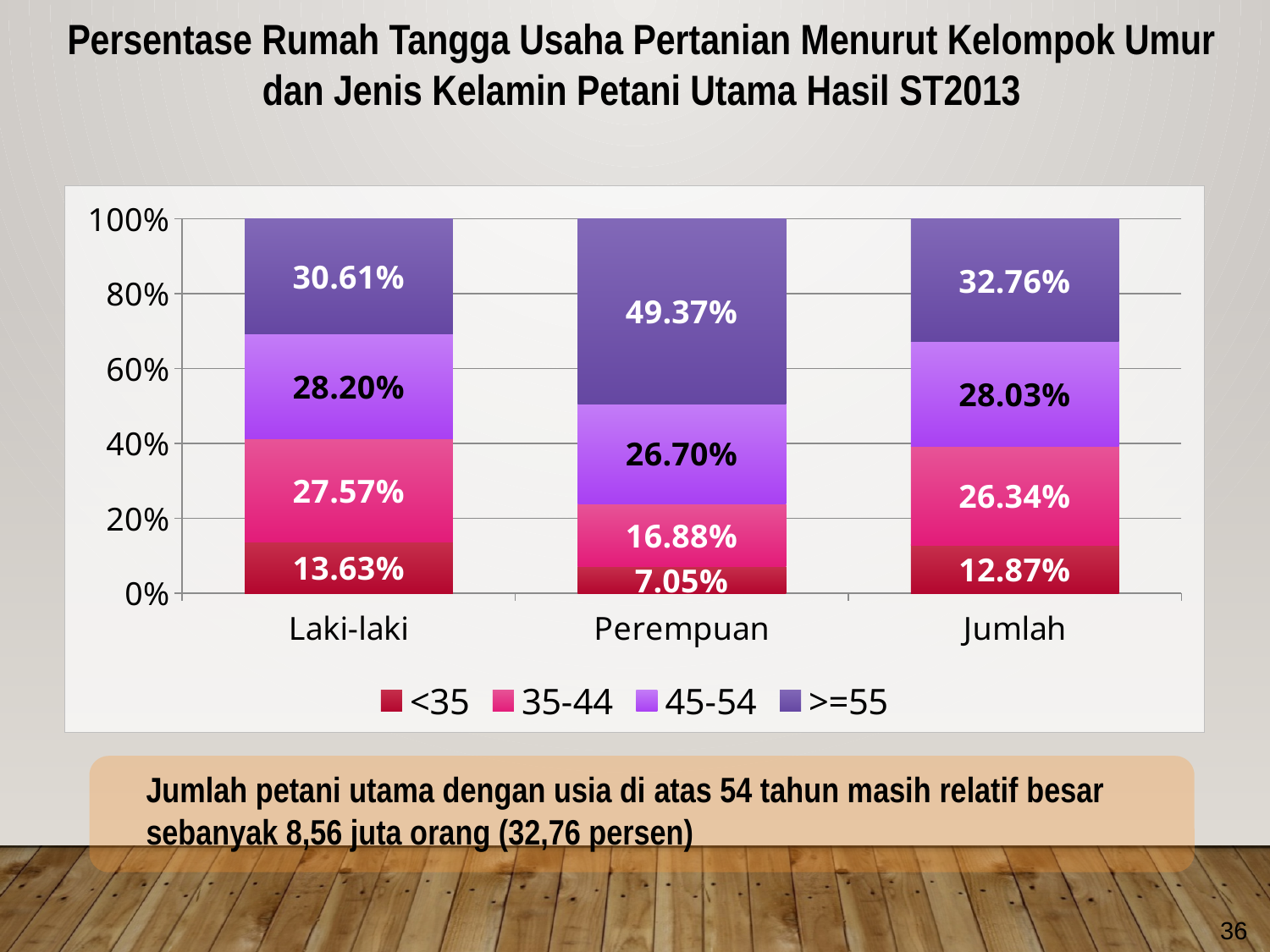
How many categories are shown on the x axis? 3 Which series is shown in the darkest purple colour at the top of each bar? >=55 What is the value for the 45-54 series in the Perempuan bar? 26.70% What is the value for the <35 series in the Laki-laki bar? 13.63% What kind of chart is shown on the slide? Stacked bar chart What is the value for the >=55 series in the Perempuan bar? 49.37% What is the value for the 35-44 series in the Jumlah bar? 26.34% Which is larger, the 35-44 value for Laki-laki or for Perempuan? Laki-laki Which category has the lowest value for the <35 series? Perempuan Which category has the highest value for the >=55 series? Perempuan What is the difference between the >=55 values for Perempuan and Laki-laki? 18.76% How many series does the legend list? 4